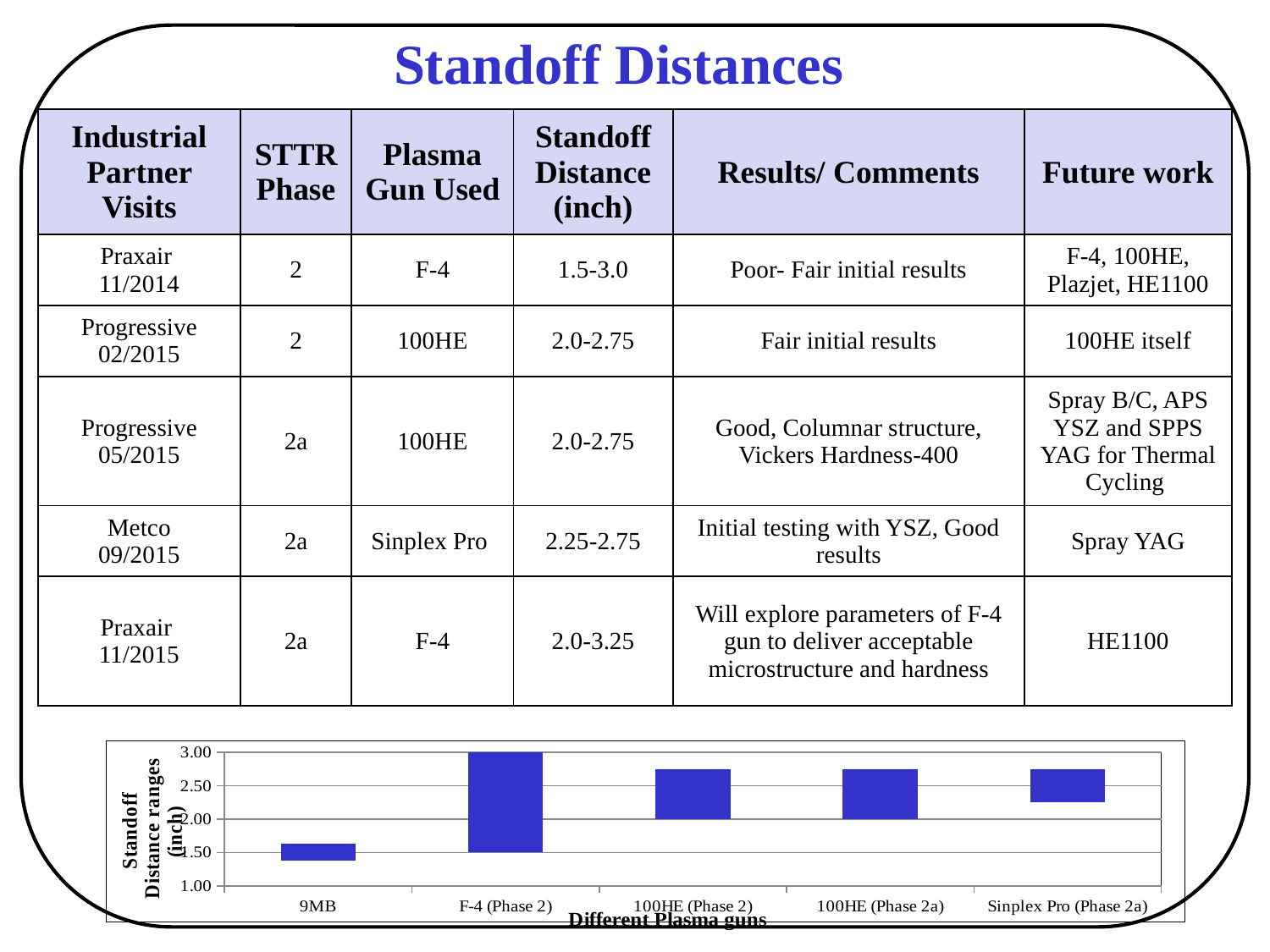
Which bar spans a larger range of standoff distances, F-4 (Phase 2) or 9MB? F-4 (Phase 2) Is the top of the F-4 (Phase 2) bar greater or less than 2.50? greater Is the top of the 9MB bar greater or less than 2.00? less What is the title of the y axis of the chart? Standoff Distance ranges (inch) Is the bottom of the Sinplex Pro (Phase 2a) bar greater or less than 2.00? greater Which plasma gun bar reaches the highest standoff distance in the chart? F-4 (Phase 2) Which plasma gun bar has the lowest standoff distance in the chart? 9MB What kind of chart is shown at the bottom of the slide? bar chart What is the title of the x axis of the chart? Different Plasma guns How many plasma gun categories are shown on the x axis of the chart? 5